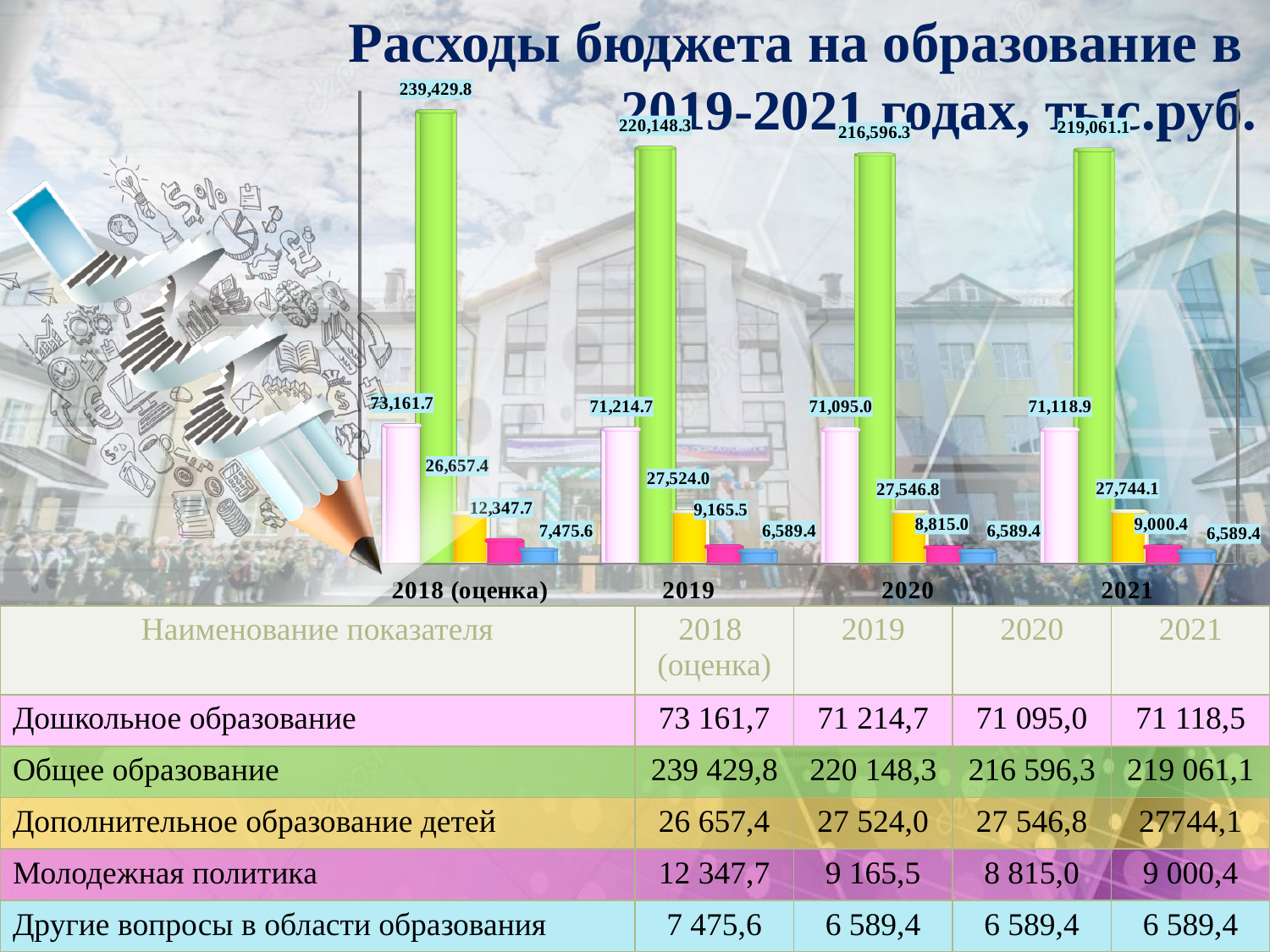
What type of chart is shown on the slide? bar chart In which year is the green bar the highest? 2018 (оценка) What is the value of the smallest (blue) bar for 2018 (оценка)? 7,475.6 Which is larger: the magenta bar for 2019 or the magenta bar for 2021? 2019 In which year is the magenta bar the lowest? 2020 What is the value of the tallest (green) bar for 2020? 216,596.3 How many year categories are shown along the x axis of the chart? 4 What is the difference between the green bar values for 2018 (оценка) and 2019? 19,281.5 Do the green bar values rise or fall from 2018 (оценка) to 2020? fall What is the value of the tallest (green) bar for 2018 (оценка)? 239,429.8 What is the value of the yellow bar for 2021? 27,744.1 What is the value of the pink bar for 2019? 71,214.7